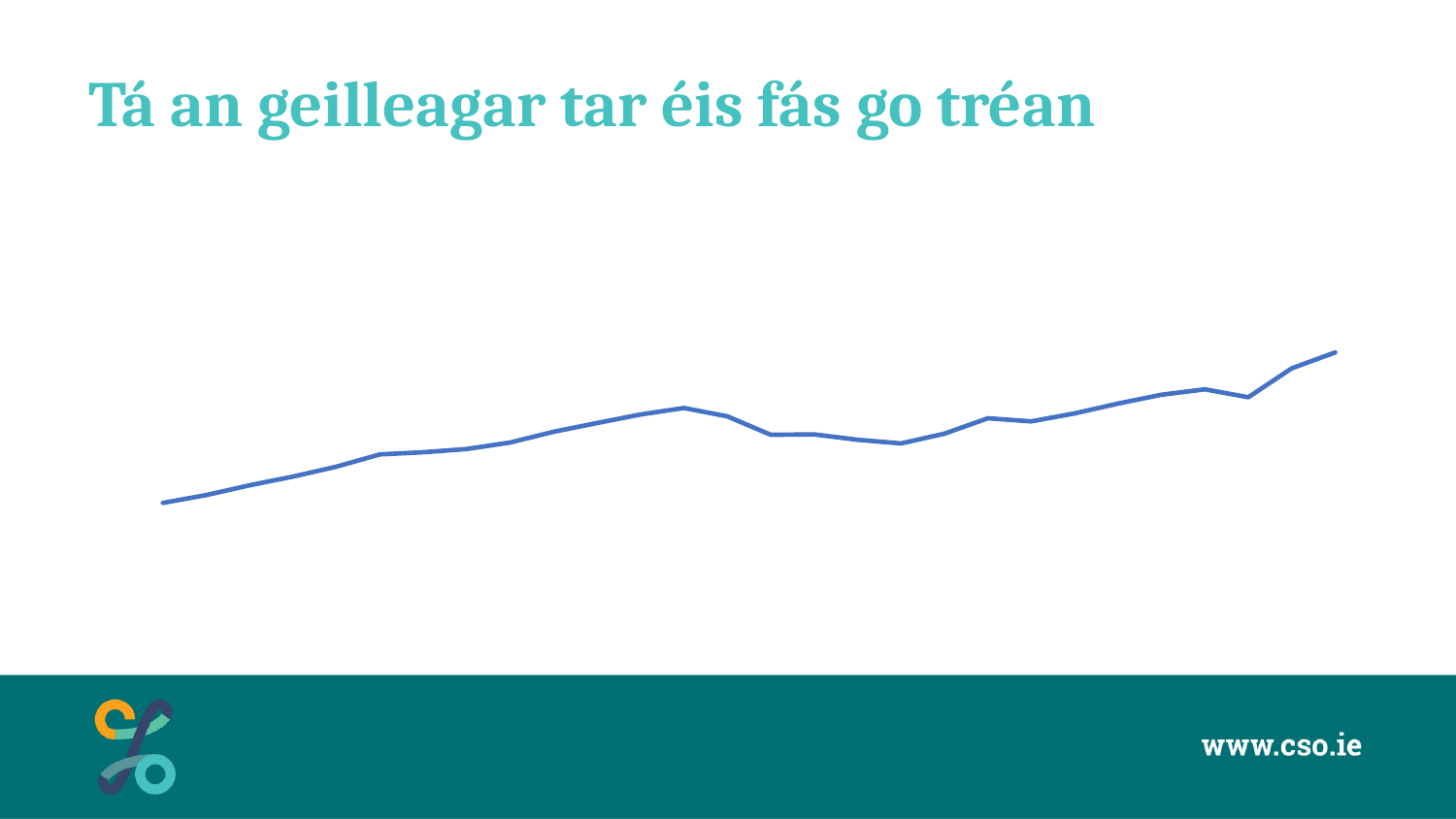
How many lines are plotted on the chart? 1 What is the title shown above the chart on the slide? Tá an geilleagar tar éis fás go tréan What colour is the line plotted on the chart? blue Do the values plotted on the line chart generally rise or fall from left to right? rise What kind of chart is shown on the slide? line chart